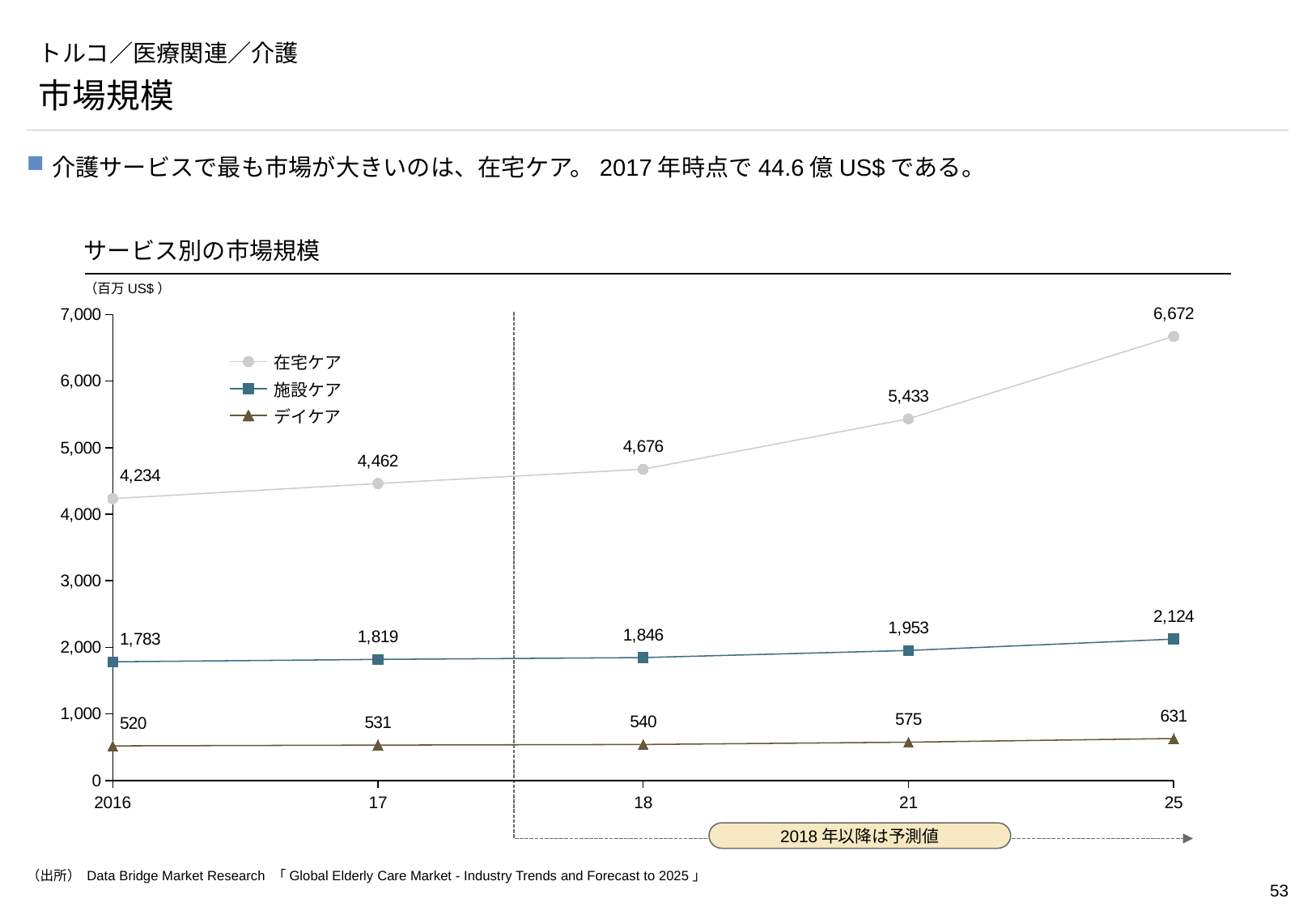
How many years are plotted on the x axis? 5 Which is larger in 2018, the value for 施設ケア or the value for デイケア? 施設ケア What kind of chart is shown? line chart What is the difference between the 在宅ケア values in 2025 and 2016? 2,438 What is the value for 施設ケア in 2021? 1,953 Is the value for 在宅ケア in 2021 greater or less than 5,000? greater How many series does the legend list? 3 Does the value for 施設ケア rise or fall from 2016 to 2025? rise What is the value for 在宅ケア in 2017? 4,462 In which year is the value for デイケア lowest? 2016 In which year is the value for 在宅ケア highest? 2025 What is the value for デイケア in 2025? 631